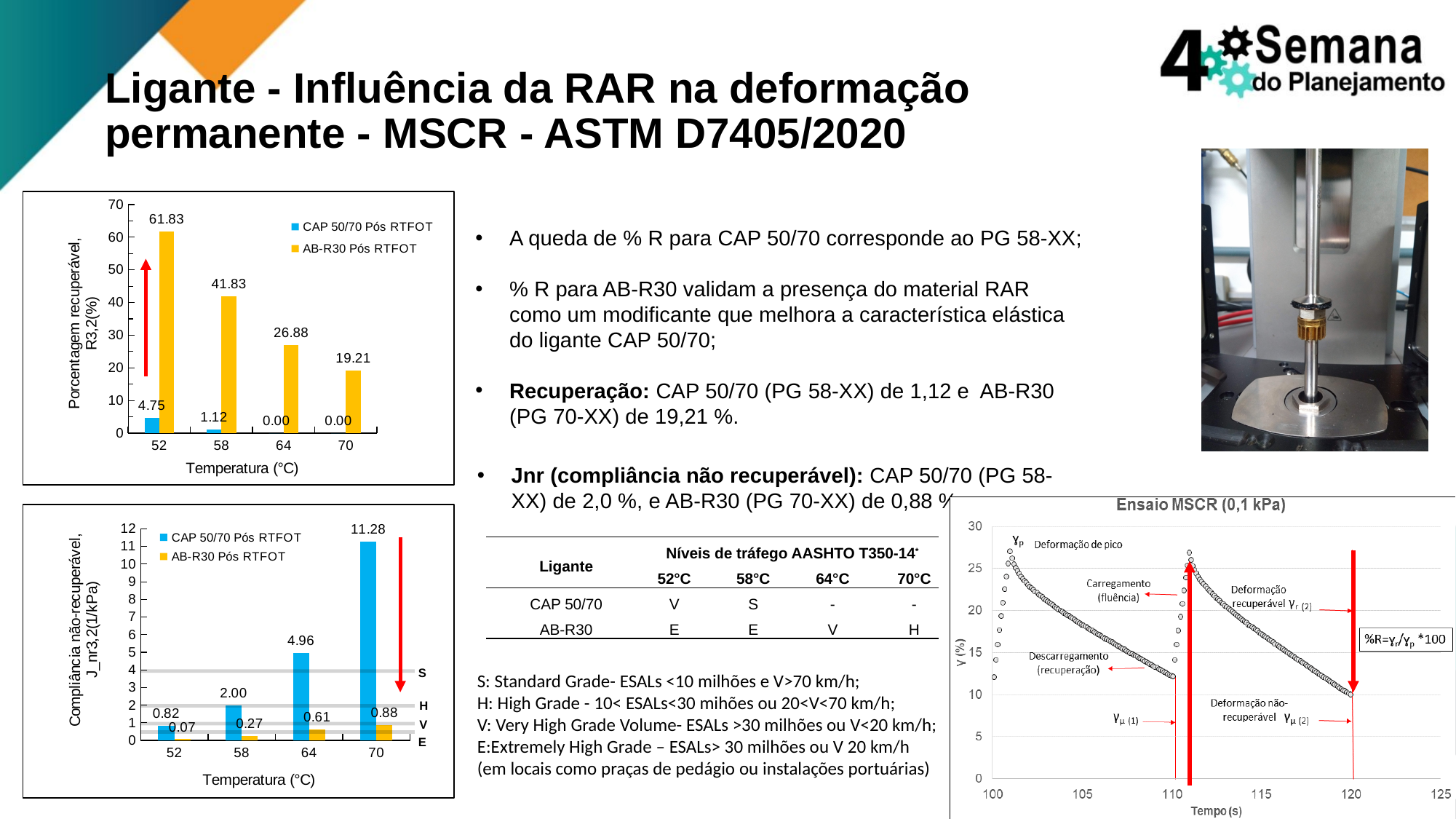
In the top-left chart (Porcentagem recuperável), what is the difference between the AB-R30 Pós RTFOT values at 52 °C and 58 °C? 20.00 In the top-left chart (Porcentagem recuperável), do the AB-R30 Pós RTFOT values rise or fall as temperature increases? fall In the bottom-left chart (Compliância não-recuperável), which series has the larger value at 64 °C? CAP 50/70 Pós RTFOT In the bottom-left chart (Compliância não-recuperável), what is the difference between CAP 50/70 Pós RTFOT and AB-R30 Pós RTFOT at 70 °C? 10.40 In the bottom-left chart (Compliância não-recuperável), what is the value for AB-R30 Pós RTFOT at 64 °C? 0.61 In the top-left chart (Porcentagem recuperável), what is the value for AB-R30 Pós RTFOT at 52 °C? 61.83 In the top-left chart (Porcentagem recuperável), what is the value for CAP 50/70 Pós RTFOT at 58 °C? 1.12 In the bottom-left chart (Compliância não-recuperável), how many series does the legend list? 2 What is the title of the chart on the bottom right of the slide? Ensaio MSCR (0,1 kPa) In the bottom-left chart (Compliância não-recuperável), what is the value for CAP 50/70 Pós RTFOT at 70 °C? 11.28 In the top-left chart (Porcentagem recuperável), how many temperature categories are shown on the x axis? 4 In the top-left chart (Porcentagem recuperável), at which temperature is the AB-R30 Pós RTFOT value highest? 52